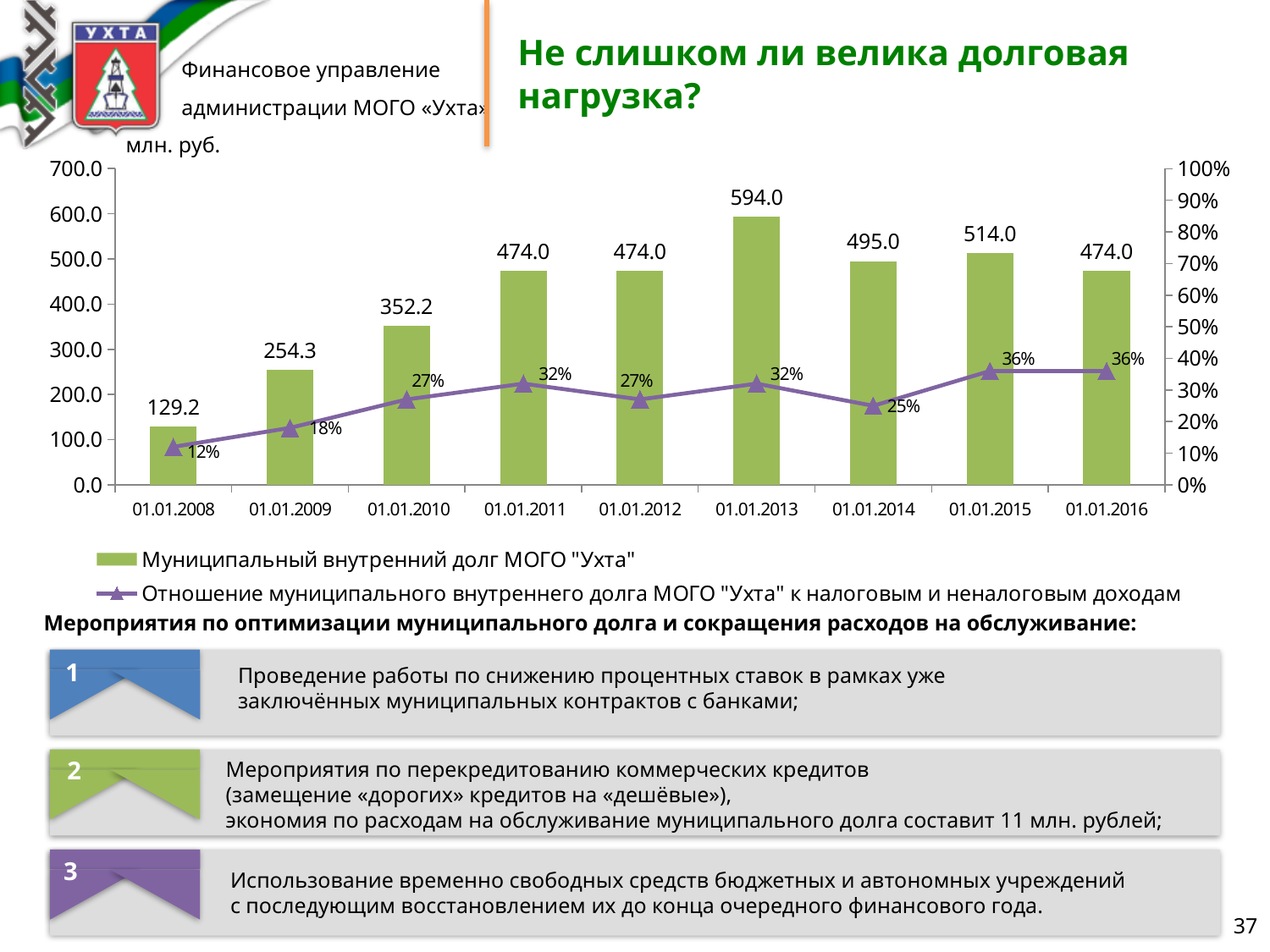
What is the value of the municipal internal debt on 01.01.2008? 129.2 What is the value of the municipal internal debt (Муниципальный внутренний долг МОГО "Ухта") on 01.01.2013? 594.0 What kind of chart is used to show the municipal internal debt? Bar chart What is the difference between the municipal internal debt on 01.01.2013 and on 01.01.2014? 99.0 On which date is the municipal internal debt the highest? 01.01.2013 What is the ratio of municipal internal debt to tax and non-tax revenues on 01.01.2014? 25% How many dates are shown on the x axis of the chart? 9 Does the municipal internal debt rise or fall from 01.01.2008 to 01.01.2011? Rise Which is larger, the municipal internal debt on 01.01.2015 or on 01.01.2016? 01.01.2015 On which date is the municipal internal debt the lowest? 01.01.2008 What is the ratio of municipal internal debt to tax and non-tax revenues on 01.01.2015? 36% How many series does the chart legend list? 2